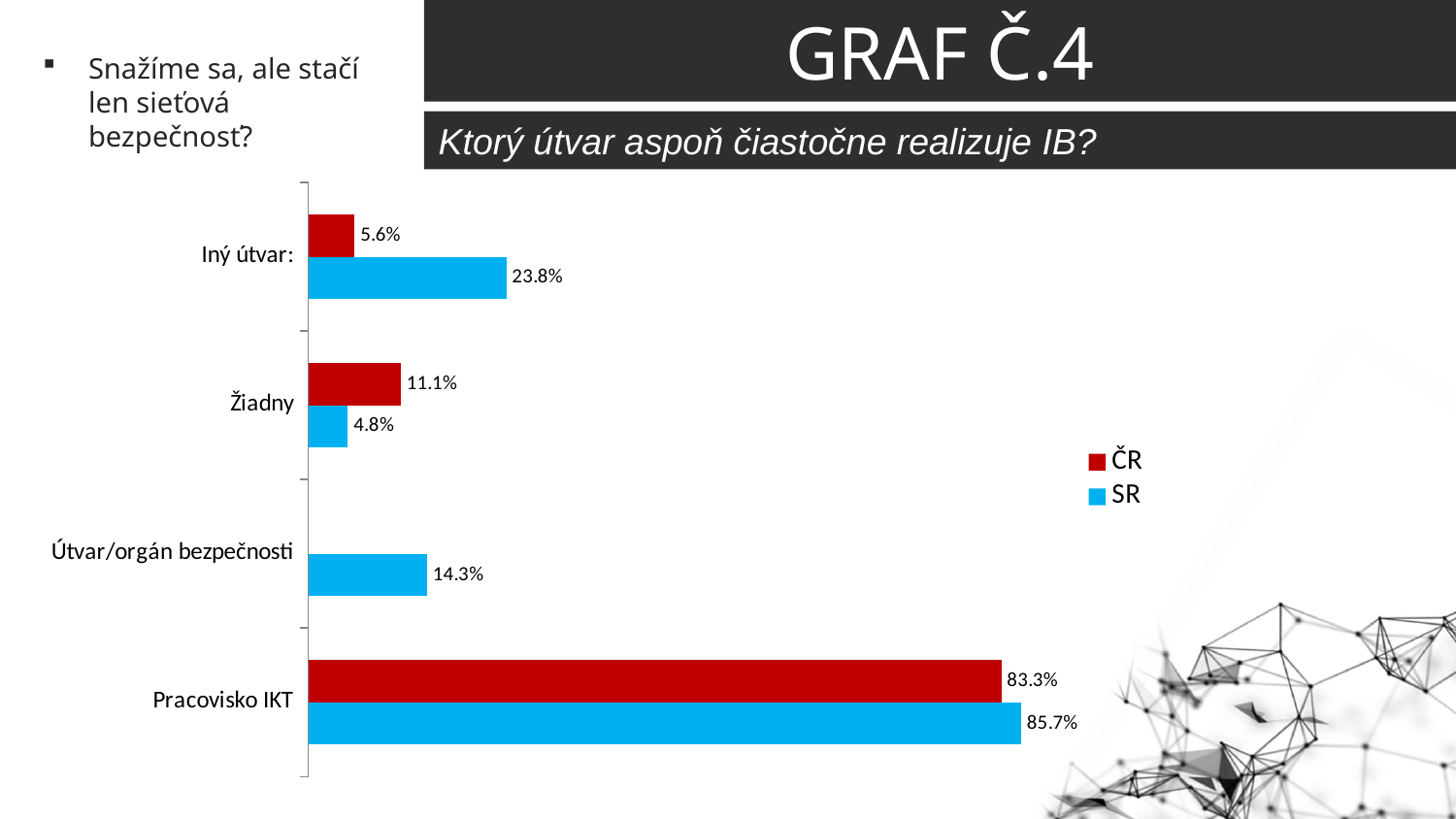
How many series does the legend list? 2 What kind of chart is shown on the slide? Bar chart What is the difference between the SR and ČR values for Pracovisko IKT? 2.4% What is the SR value for Pracovisko IKT? 85.7% For Iný útvar, which series has the larger value, ČR or SR? SR How many categories are shown on the chart? 4 Which category has the lowest SR value? Žiadny Which category has the highest SR value? Pracovisko IKT What is the ČR value for Žiadny? 11.1% What is the ČR value for Iný útvar? 5.6% What is the SR value for Útvar/orgán bezpečnosti? 14.3% For Žiadny, which series has the larger value, ČR or SR? ČR